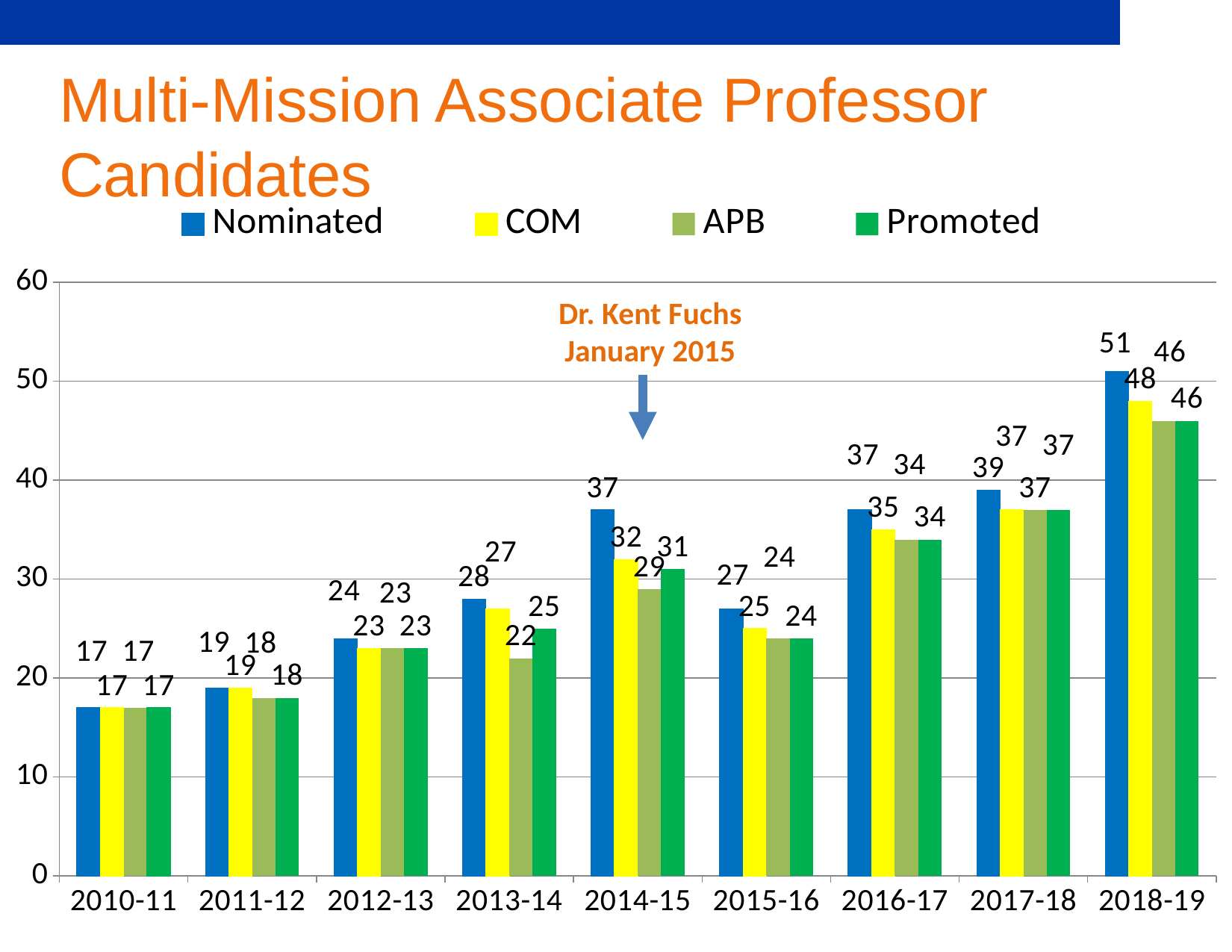
Which year has the highest Nominated value? 2018-19 What is the APB value for 2013-14? 22 What is the difference between the Nominated and Promoted values in 2014-15? 6 What annotation text appears above the 2014-15 bars? Dr. Kent Fuchs January 2015 What is the Promoted value for 2014-15? 31 What is the Nominated value for 2018-19? 51 What is the COM value for 2016-17? 35 How many years are shown on the x axis? 9 What kind of chart is shown on the slide? Bar chart Which year has the lowest Promoted value? 2010-11 Which is larger, the Nominated value for 2015-16 or the Nominated value for 2016-17? 2016-17 How many series does the legend list? 4